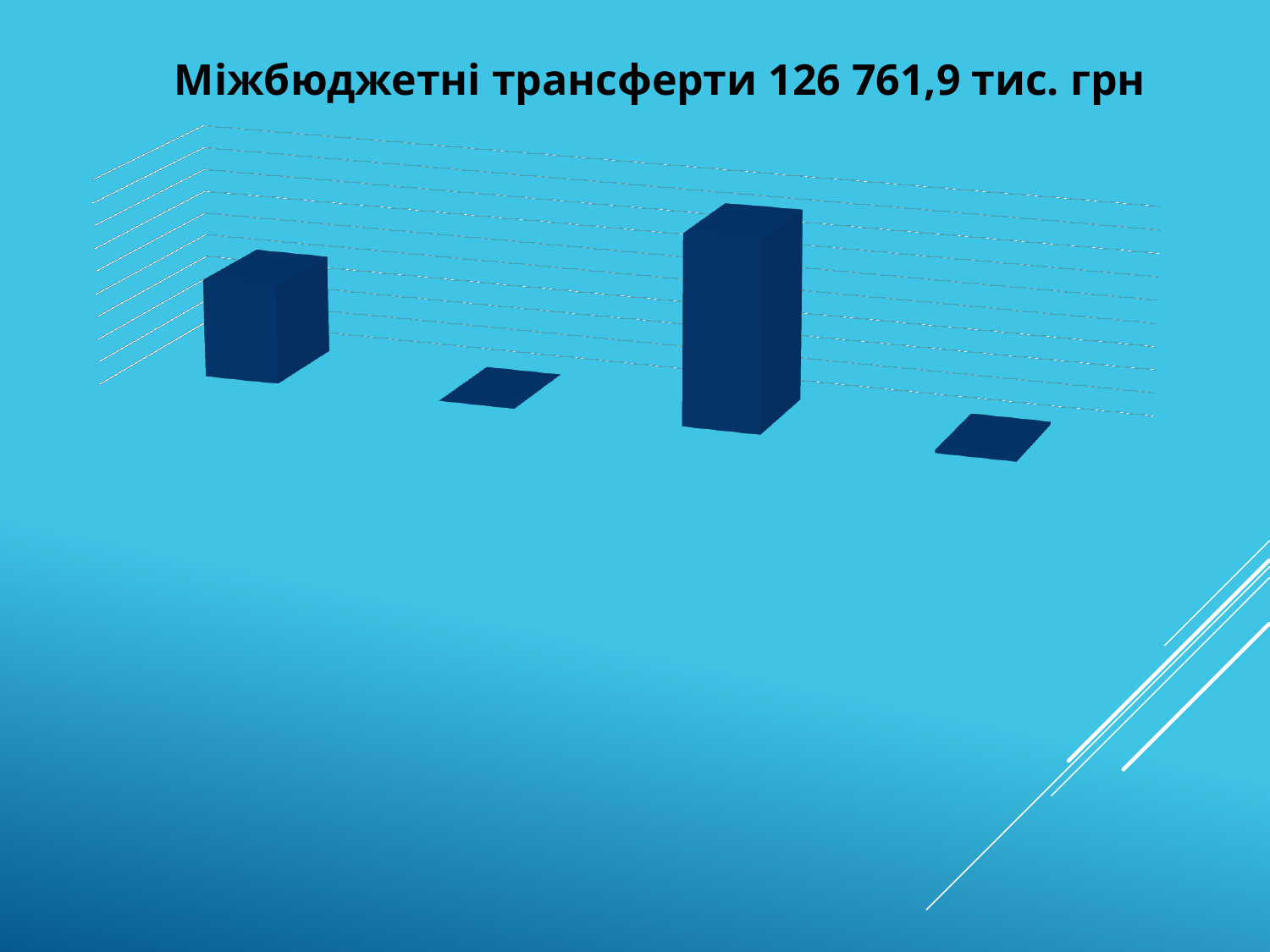
What kind of chart is shown on the slide? bar chart Which is larger, the first bar from the left or the third bar from the left? the third bar What is the title of the chart? Міжбюджетні трансферти 126 761,9 тис. грн What total amount in thousand UAH is stated in the chart title? 126 761,9 тис. грн How many bars does the chart show? 4 Which bar, counted from the left, is the tallest? the third Which is larger, the first bar from the left or the second bar from the left? the first bar Which is larger, the third bar from the left or the fourth bar from the left? the third bar